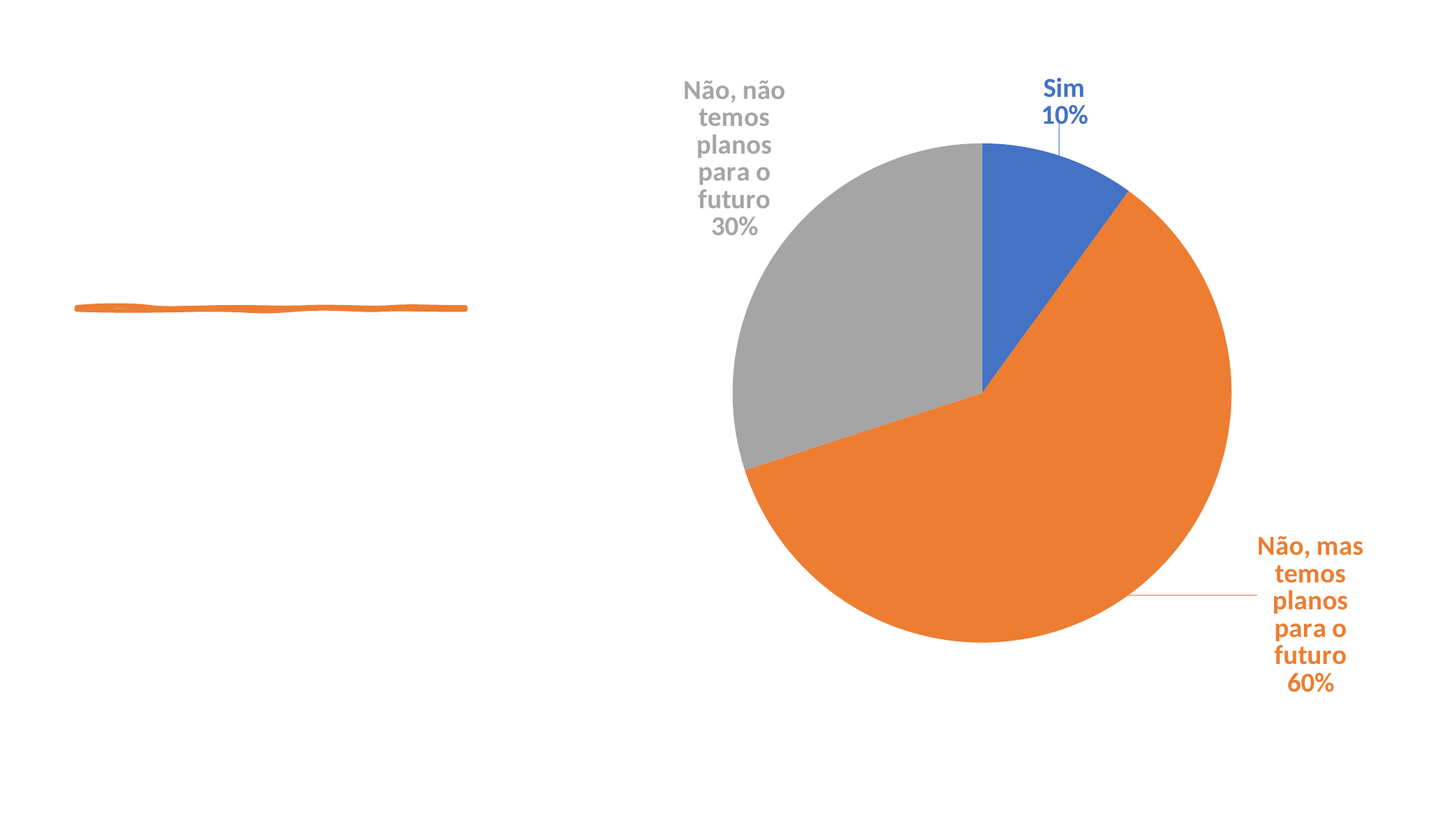
How many slices does the pie chart have? 3 What is the value for "Não, não temos planos para o futuro"? 30% Which is larger, "Sim" or "Não, não temos planos para o futuro"? Não, não temos planos para o futuro Which category has the largest slice? Não, mas temos planos para o futuro What is the difference between "Não, mas temos planos para o futuro" and "Não, não temos planos para o futuro"? 30% Which category has the smallest slice? Sim What is the value for "Sim"? 10% What is the value for "Não, mas temos planos para o futuro"? 60% What colour is the "Sim" slice? blue What kind of chart is shown on the slide? pie chart What colour is the "Não, não temos planos para o futuro" slice? grey What is the difference between "Não, não temos planos para o futuro" and "Sim"? 20%